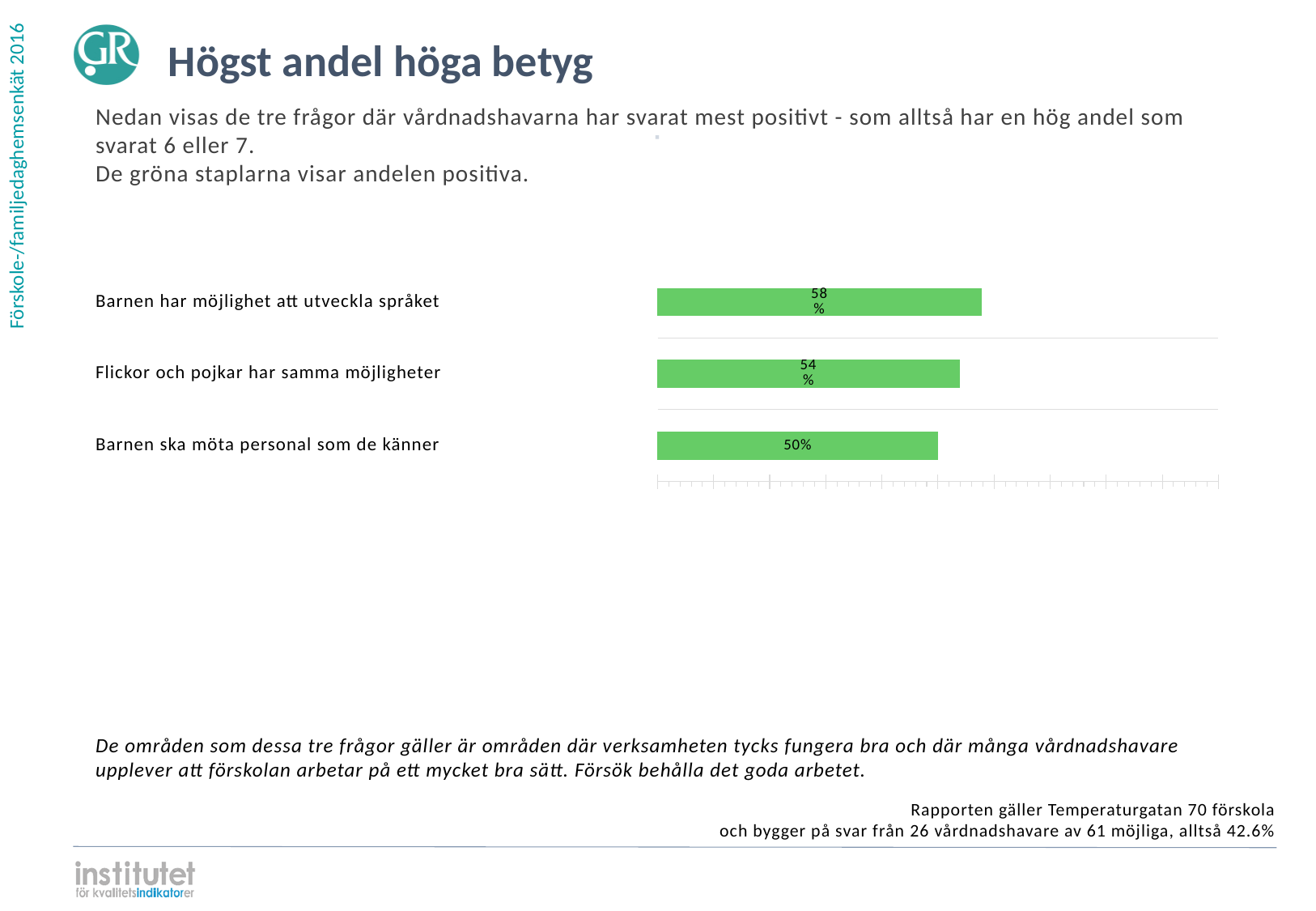
What is the title of the slide containing the chart? Högst andel höga betyg What is the value for "Barnen har möjlighet att utveckla språket"? 58% What colour are the bars in the chart? Green What is the value for "Barnen ska möta personal som de känner"? 50% What is the difference between the values for "Flickor och pojkar har samma möjligheter" and "Barnen ska möta personal som de känner"? 4% Which category has the highest value? Barnen har möjlighet att utveckla språket What kind of chart is shown on the slide? Bar chart What is the value for "Flickor och pojkar har samma möjligheter"? 54% What is the difference between the values for "Barnen har möjlighet att utveckla språket" and "Barnen ska möta personal som de känner"? 8% Which category has the lowest value? Barnen ska möta personal som de känner How many categories are shown in the chart? 3 Which is larger: the value for "Flickor och pojkar har samma möjligheter" or for "Barnen ska möta personal som de känner"? Flickor och pojkar har samma möjligheter